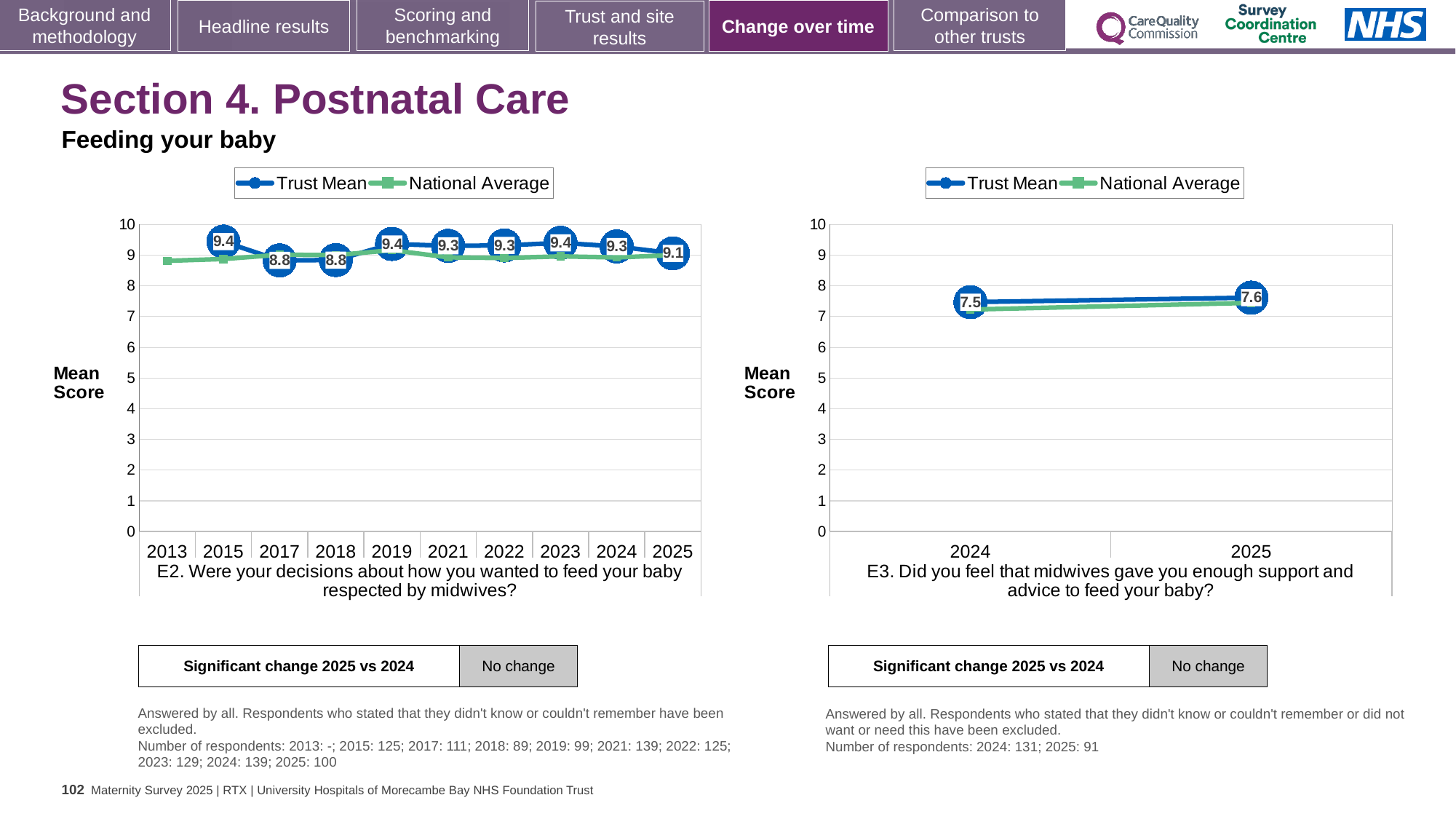
What kind of chart is the right chart (E3)? line chart On the left chart (E2), what is the Trust Mean score for 2025? 9.1 On the right chart (E3), what is the Trust Mean score for 2025? 7.6 On the left chart (E2), how many years are shown on the x axis? 10 On the left chart (E2), what is the Trust Mean score for 2017? 8.8 On the left chart (E2), what is the difference between the Trust Mean scores for 2024 and 2025? 0.2 On the left chart (E2), what is the Trust Mean score for 2023? 9.4 On the left chart (E2), which year has the larger Trust Mean score, 2015 or 2018? 2015 On the left chart (E2), is the National Average value for 2013 greater or less than 8? greater On the right chart (E3), does the Trust Mean rise or fall from 2024 to 2025? rise On the right chart (E3), how many series does the legend list? 2 On the right chart (E3), what is the Trust Mean score for 2024? 7.5